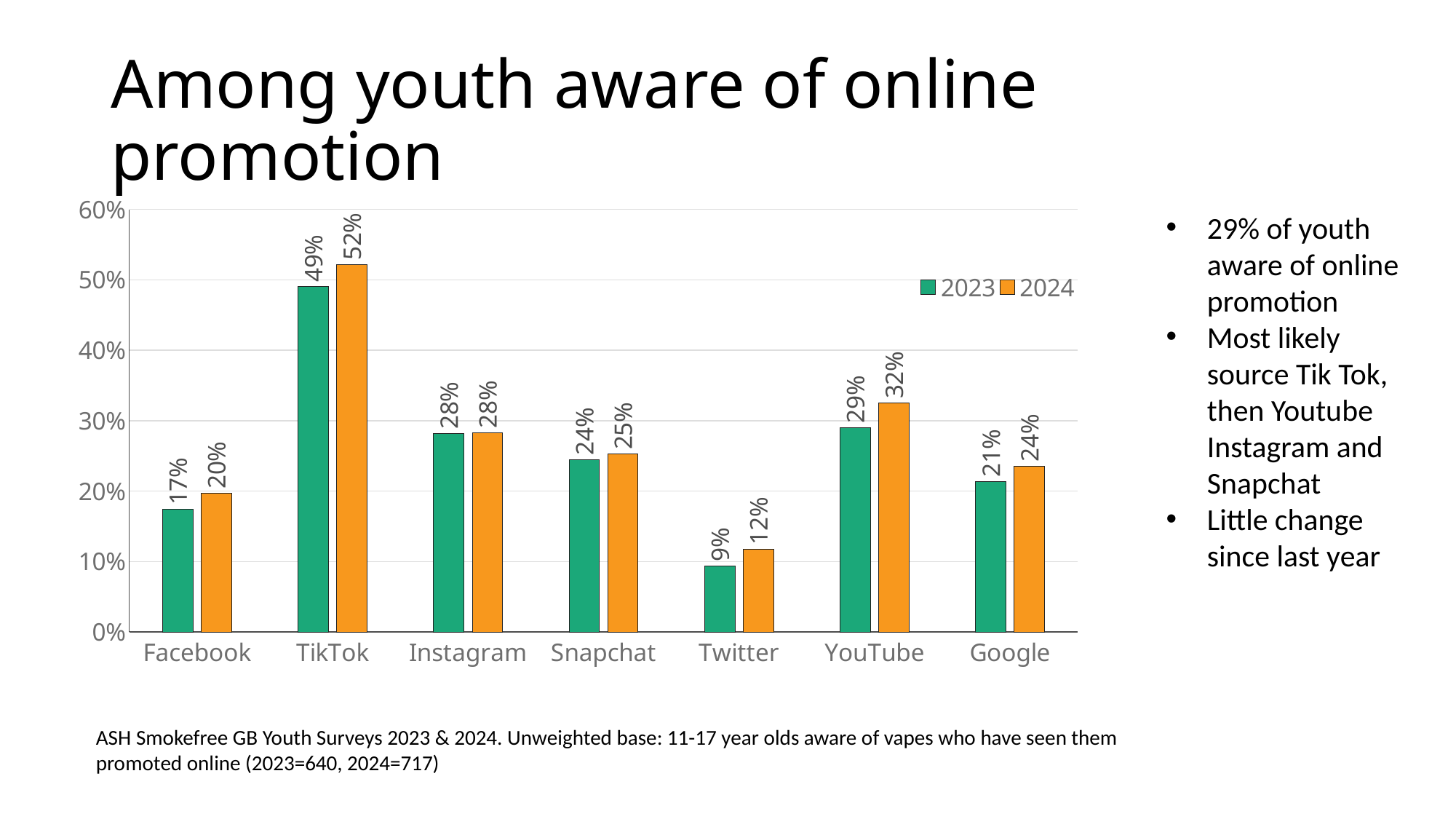
What is the difference between the 2024 and 2023 values for YouTube? 3% Which colour represents the 2024 series? Orange Is the 2023 value for TikTok greater or less than 40%? greater Which platform has the lowest 2023 value? Twitter What kind of chart is shown on the slide? Bar chart How many platforms are shown on the x axis? 7 How many series does the legend list? 2 What is the 2023 value for YouTube? 29% What is the 2024 value for TikTok? 52% Which platform has the highest 2024 value? TikTok Which is larger for Google: the 2023 value or the 2024 value? 2024 What is the 2024 value for Twitter? 12%